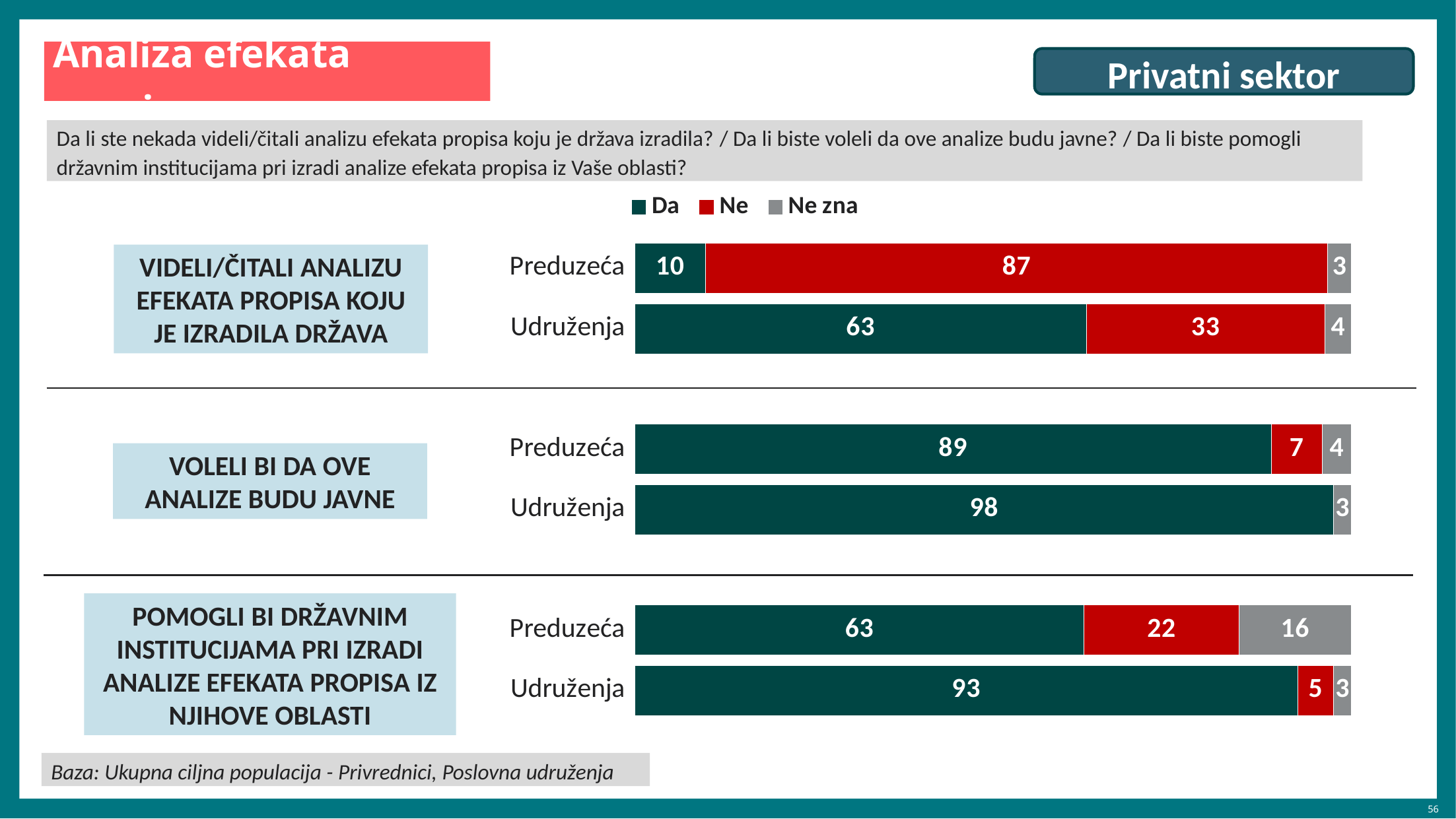
In the chart 'POMOGLI BI DRŽAVNIM INSTITUCIJAMA PRI IZRADI ANALIZE EFEKATA PROPISA IZ NJIHOVE OBLASTI', what is the total of the stacked bar for Preduzeća? 101 In the chart 'POMOGLI BI DRŽAVNIM INSTITUCIJAMA PRI IZRADI ANALIZE EFEKATA PROPISA IZ NJIHOVE OBLASTI', what is the difference between the 'Da' values for Udruženja and Preduzeća? 30 In the chart 'VIDELI/ČITALI ANALIZU EFEKATA PROPISA KOJU JE IZRADILA DRŽAVA', what is the difference between the 'Ne' values for Preduzeća and Udruženja? 54 Which colour represents the 'Ne' series in the legend? Red In the chart 'VIDELI/ČITALI ANALIZU EFEKATA PROPISA KOJU JE IZRADILA DRŽAVA', what is the total of the stacked bar for Preduzeća? 100 In the chart 'VIDELI/ČITALI ANALIZU EFEKATA PROPISA KOJU JE IZRADILA DRŽAVA', what is the 'Ne' value for Udruženja? 33 In the chart 'VOLELI BI DA OVE ANALIZE BUDU JAVNE', which has the larger 'Da' value, Preduzeća or Udruženja? Udruženja In the chart 'POMOGLI BI DRŽAVNIM INSTITUCIJAMA PRI IZRADI ANALIZE EFEKATA PROPISA IZ NJIHOVE OBLASTI', what is the 'Ne zna' value for Preduzeća? 16 How many series does the legend list? 3 In the chart 'VOLELI BI DA OVE ANALIZE BUDU JAVNE', what is the 'Da' value for Udruženja? 98 In the chart 'VIDELI/ČITALI ANALIZU EFEKATA PROPISA KOJU JE IZRADILA DRŽAVA', what is the 'Da' value for Preduzeća? 10 What kind of chart is used on this slide? Stacked bar chart